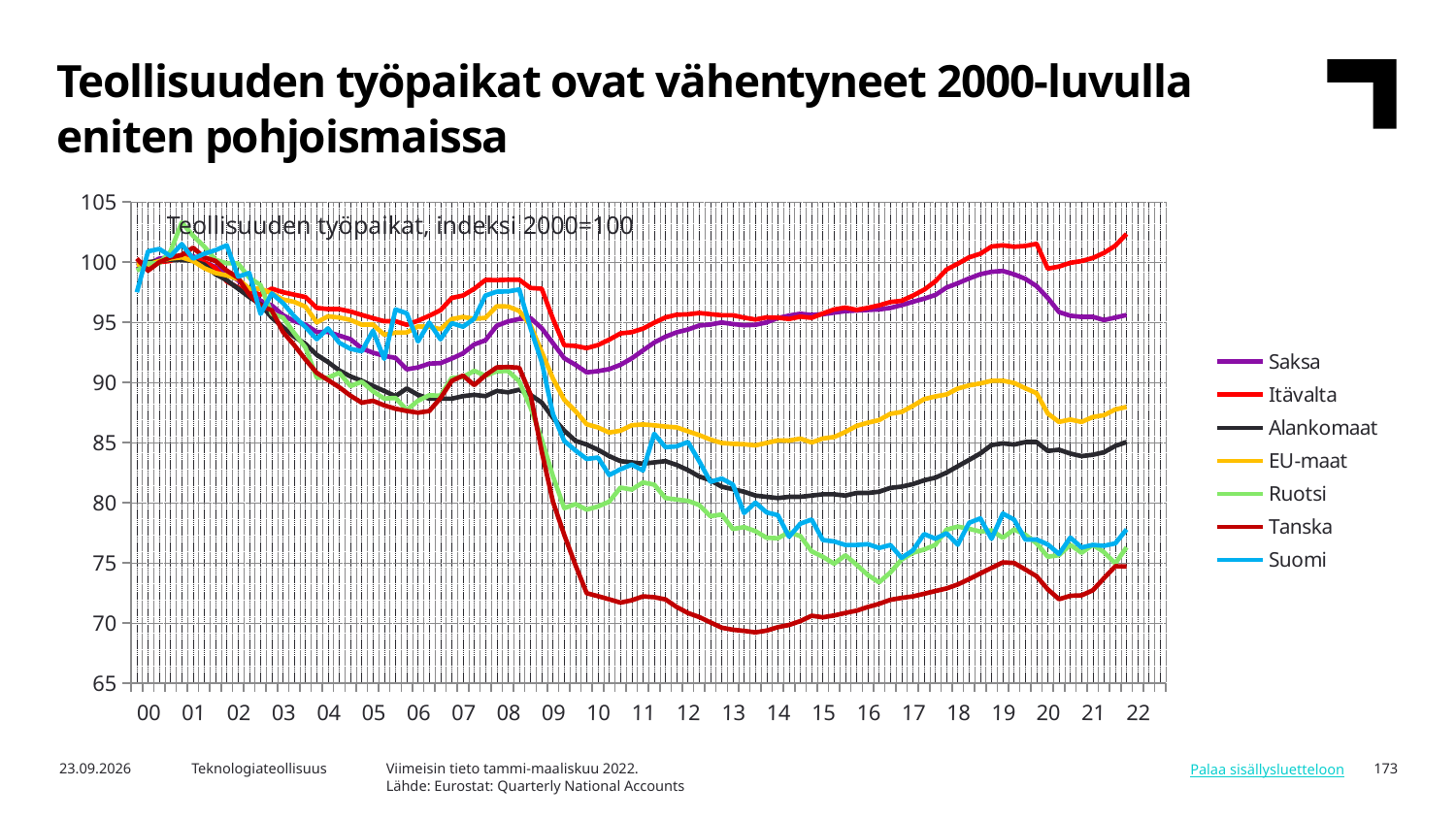
Does the Tanska line rise or fall between 2008 and 2010? fall What is the title printed inside the chart area? Teollisuuden työpaikat, indeksi 2000=100 How many series does the legend list? 7 Which series is drawn in red in the chart? Itävalta Is the value for Ruotsi in 2016 greater or less than 80? less Which series has the lowest value in 2014? Tanska Is the value for Alankomaat in 2014 greater or less than 85? less What kind of chart is shown on the slide? line chart Is the value for Tanska in 2014 greater or less than 75? less How many year labels are shown on the x axis? 23 Which series has the highest value in 2022? Itävalta